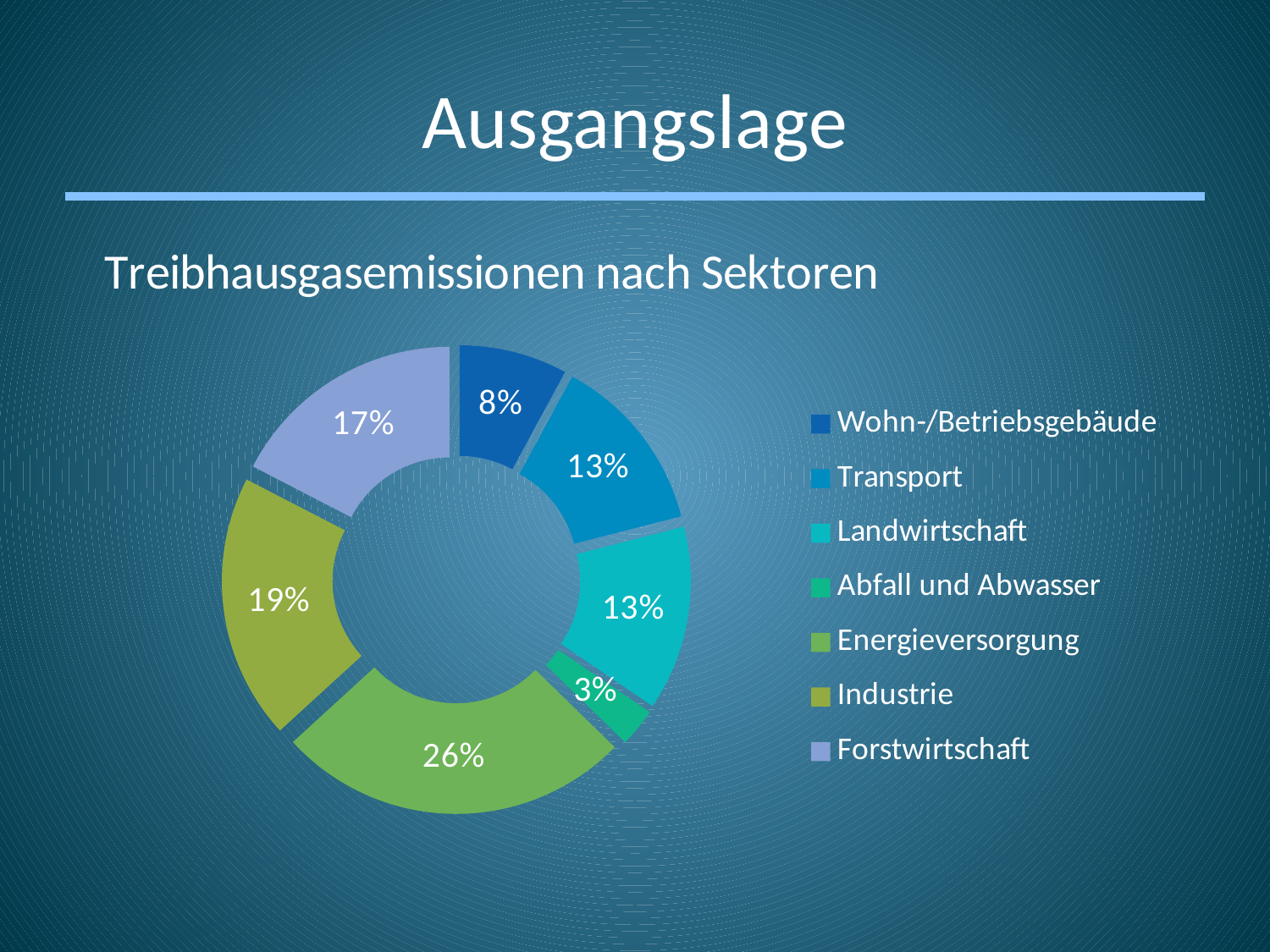
What is the difference in percentage points between Forstwirtschaft and Wohn-/Betriebsgebäude? 9 How many sectors are shown in the chart? 7 What type of chart is shown on the slide? Doughnut chart Which has a larger share, Industrie or Forstwirtschaft? Industrie Which sector has the largest share of emissions? Energieversorgung What percentage is shown for Wohn-/Betriebsgebäude? 8% What is the difference in percentage points between Energieversorgung and Industrie? 7 What share does Forstwirtschaft have? 17% What is the value for Industrie? 19% What is the title of the chart? Treibhausgasemissionen nach Sektoren What share of greenhouse gas emissions does Energieversorgung account for? 26% Which sector has the smallest share of emissions? Abfall und Abwasser